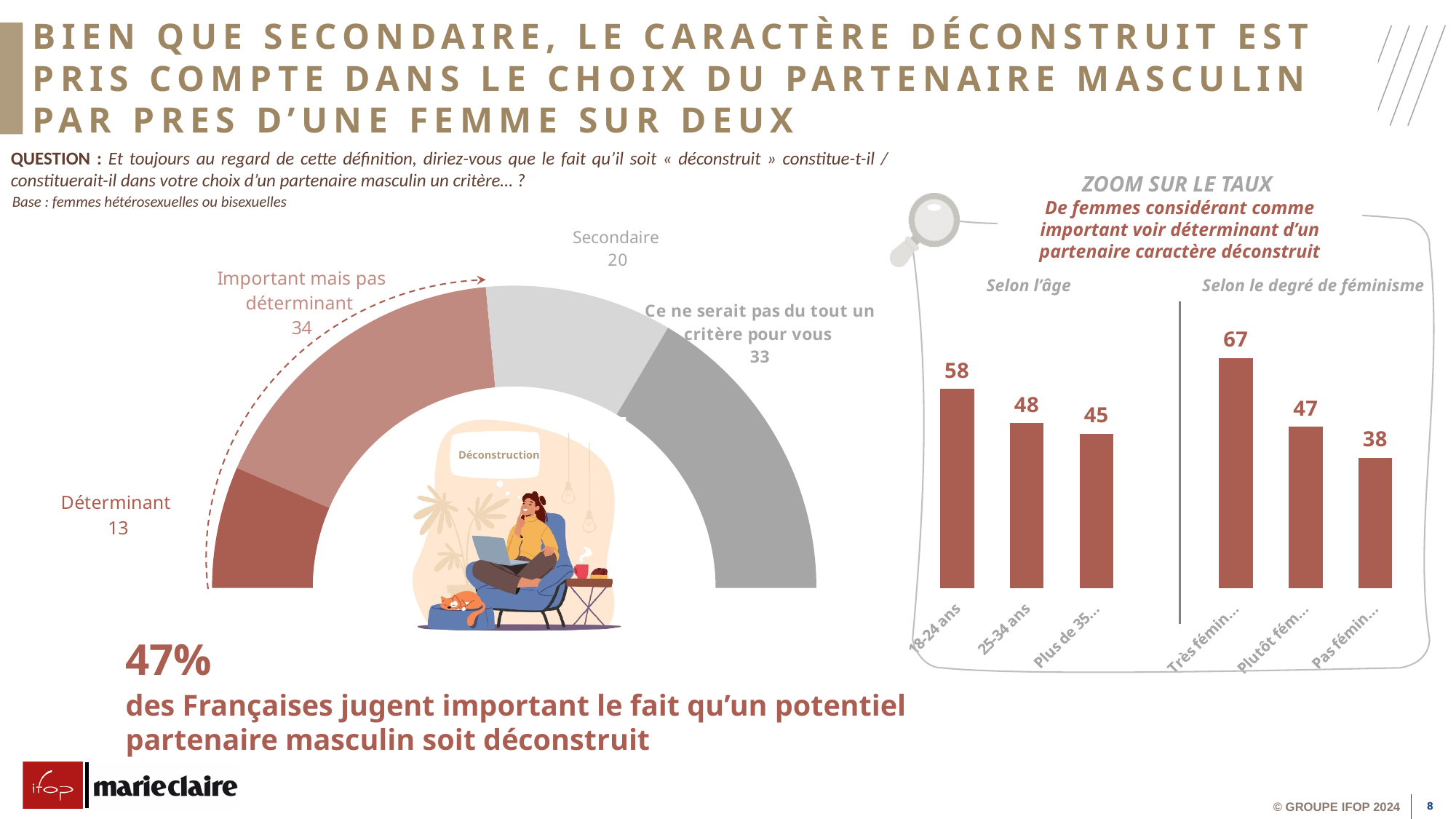
In the semicircle chart on the left, which segment has the lowest value? Déterminant In the "Zoom sur le taux" bar chart on the right, what is the value for "25-34 ans"? 48 In the semicircle chart on the left, how many segments are shown? 4 In the "Zoom sur le taux" bar chart on the right, which category has the highest value? Très fémin... In the "Zoom sur le taux" bar chart on the right, what is the value for "18-24 ans"? 58 In the semicircle chart on the left, what value is shown for "Déterminant"? 13 What kind of chart is the "Zoom sur le taux" chart on the right? Bar chart In the semicircle chart on the left, which segment has the highest value? Important mais pas déterminant In the semicircle chart on the left, what is the difference between "Ce ne serait pas du tout un critère pour vous" and "Secondaire"? 13 In the semicircle chart on the left, what value is shown for "Secondaire"? 20 In the semicircle chart on the left, what value is shown for "Important mais pas déterminant"? 34 In the "Zoom sur le taux" bar chart on the right, what is the difference between the first bar under "Selon le degré de féminisme" (67) and the last bar (38)? 29